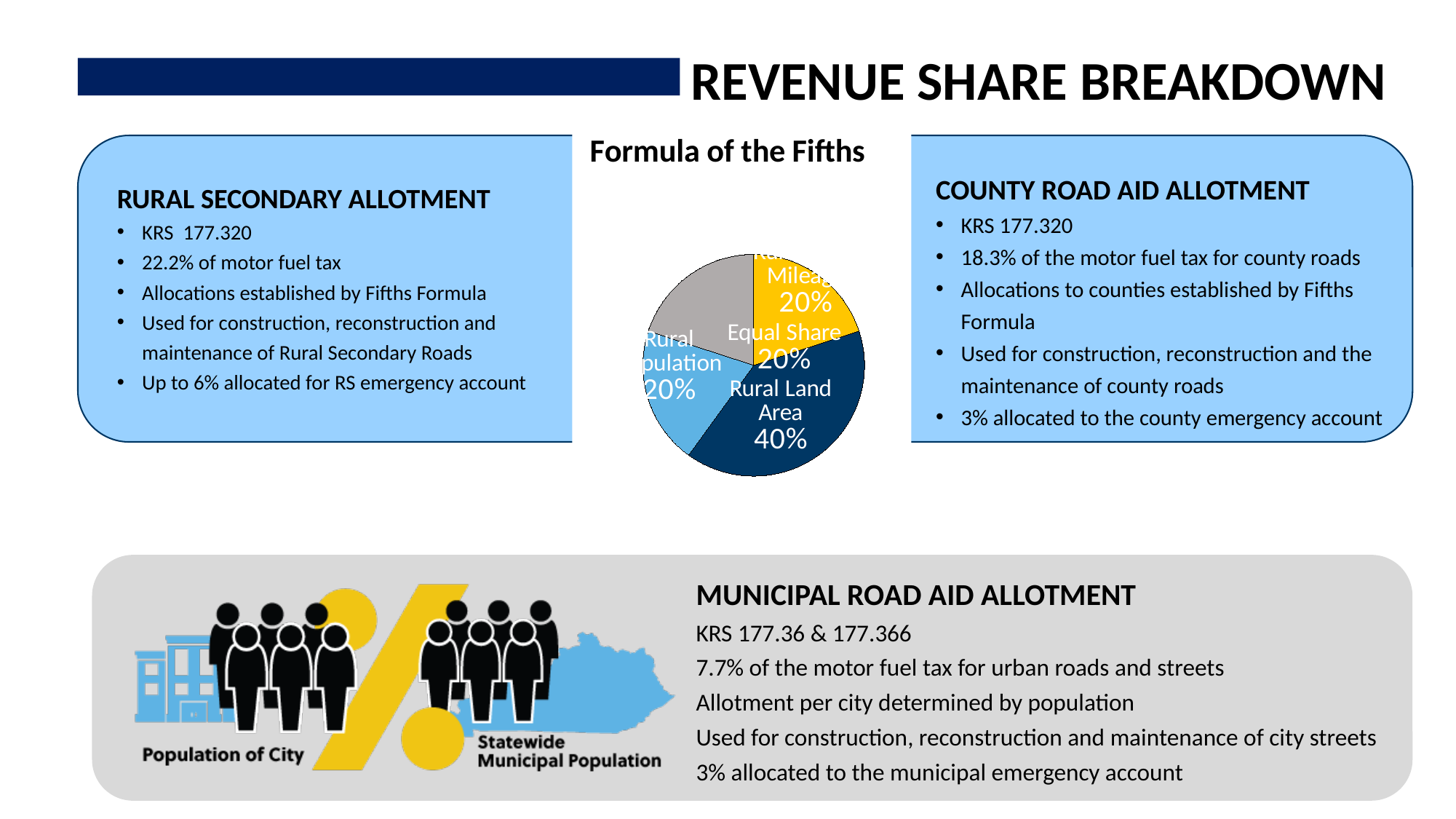
In the pie chart, what percentage is shown for Rural Land Area? 40% In the pie chart, what do the Equal Share, Rural Population and Rural Mileage slices add up to? 60% How many slices does the pie chart have? 4 Which slice of the pie chart is the largest? Rural Land Area What colour is the Rural Land Area slice in the pie chart? dark blue In the pie chart, which is larger: Rural Land Area or Rural Population? Rural Land Area In the pie chart, what percentage is shown for Rural Population? 20% In the pie chart, what percentage is shown for Equal Share? 20% What share of the pie does the Rural Land Area slice represent? 40% What kind of chart is shown under the heading "Formula of the Fifths"? pie chart In the pie chart, what is the difference between the Rural Land Area share and the Equal Share share? 20% What is the title of the pie chart? Formula of the Fifths